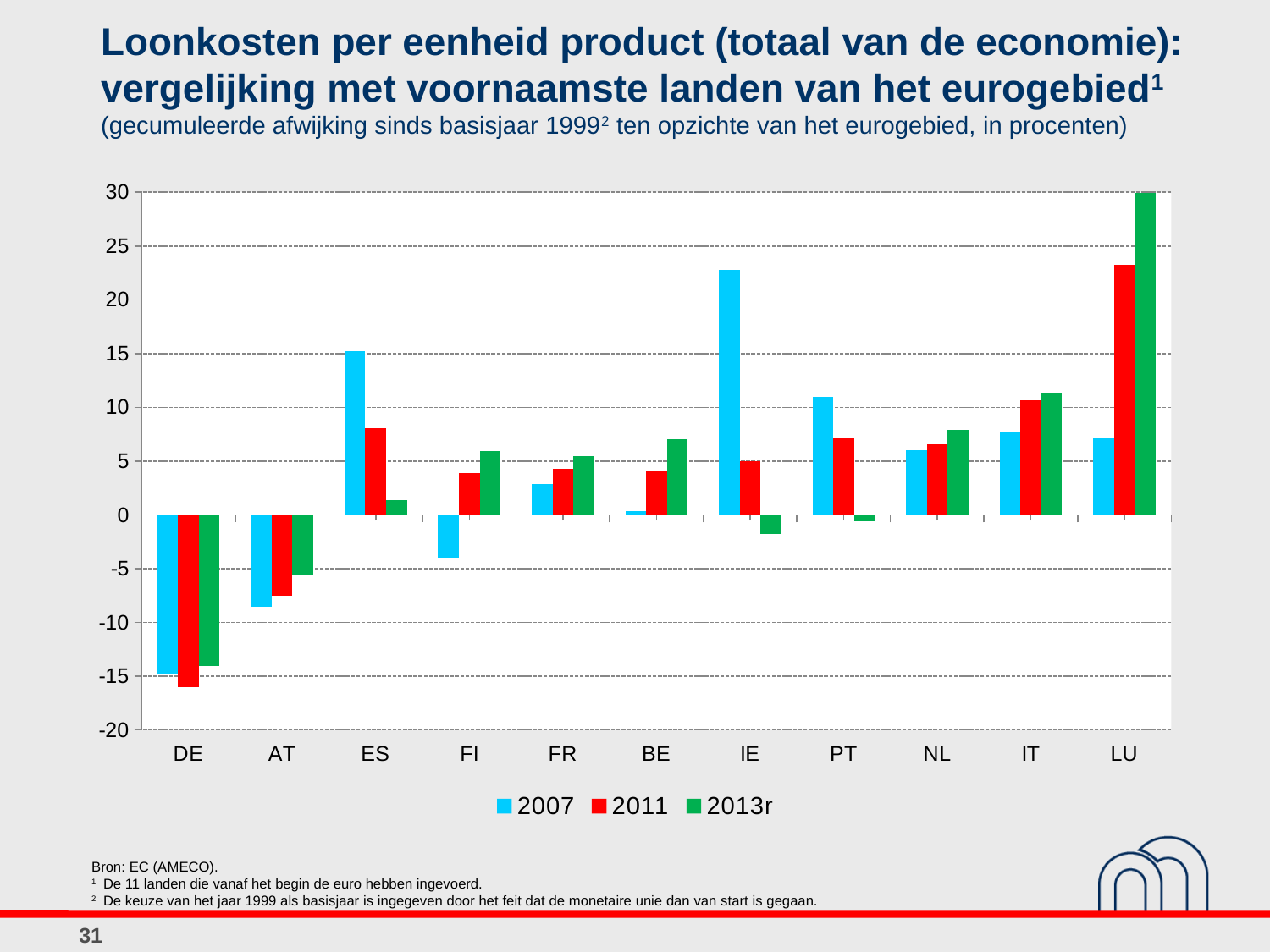
How many countries are shown on the x axis of the chart? 11 For ES, do the values rise or fall from 2007 to 2011 to 2013r? fall Which country has the highest value for the 2007 series? IE Which country has the highest value for the 2013r series? LU Is the 2007 value for DE greater or less than -10? less Which country has the lowest value for the 2013r series? DE Is the 2007 value for IE greater or less than 20? greater How many series does the legend list? 3 What kind of chart is shown on the slide? bar chart Is the 2011 value for LU greater or less than 20? greater For ES, which is larger: the 2007 value or the 2011 value? 2007 Which series are listed in the legend? 2007, 2011, 2013r